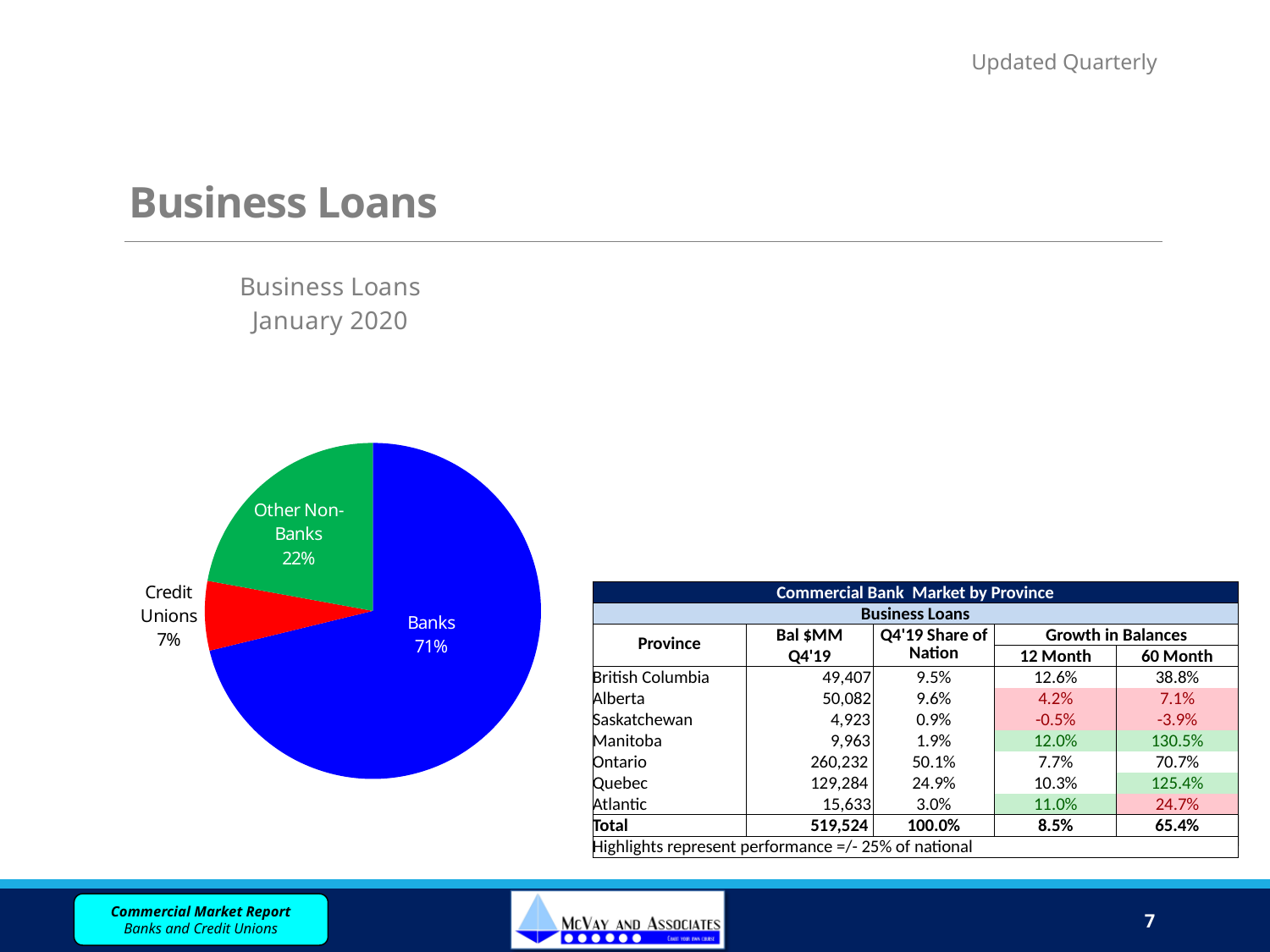
Which is larger in the pie chart, Other Non-Banks or Credit Unions? Other Non-Banks How many slices does the pie chart have? 3 Which slice of the pie chart is the largest? Banks What share of the pie chart do Banks hold? 71% What share of the pie chart do Other Non-Banks hold? 22% What is the title of the pie chart? Business Loans January 2020 What is the difference in percentage points between the Banks slice and the Other Non-Banks slice? 49 What colour is the Banks slice in the pie chart? blue What share of the pie chart do Credit Unions hold? 7% What type of chart is shown on the slide? pie chart Which slice of the pie chart is the smallest? Credit Unions What is the difference in percentage points between the Other Non-Banks slice and the Credit Unions slice? 15